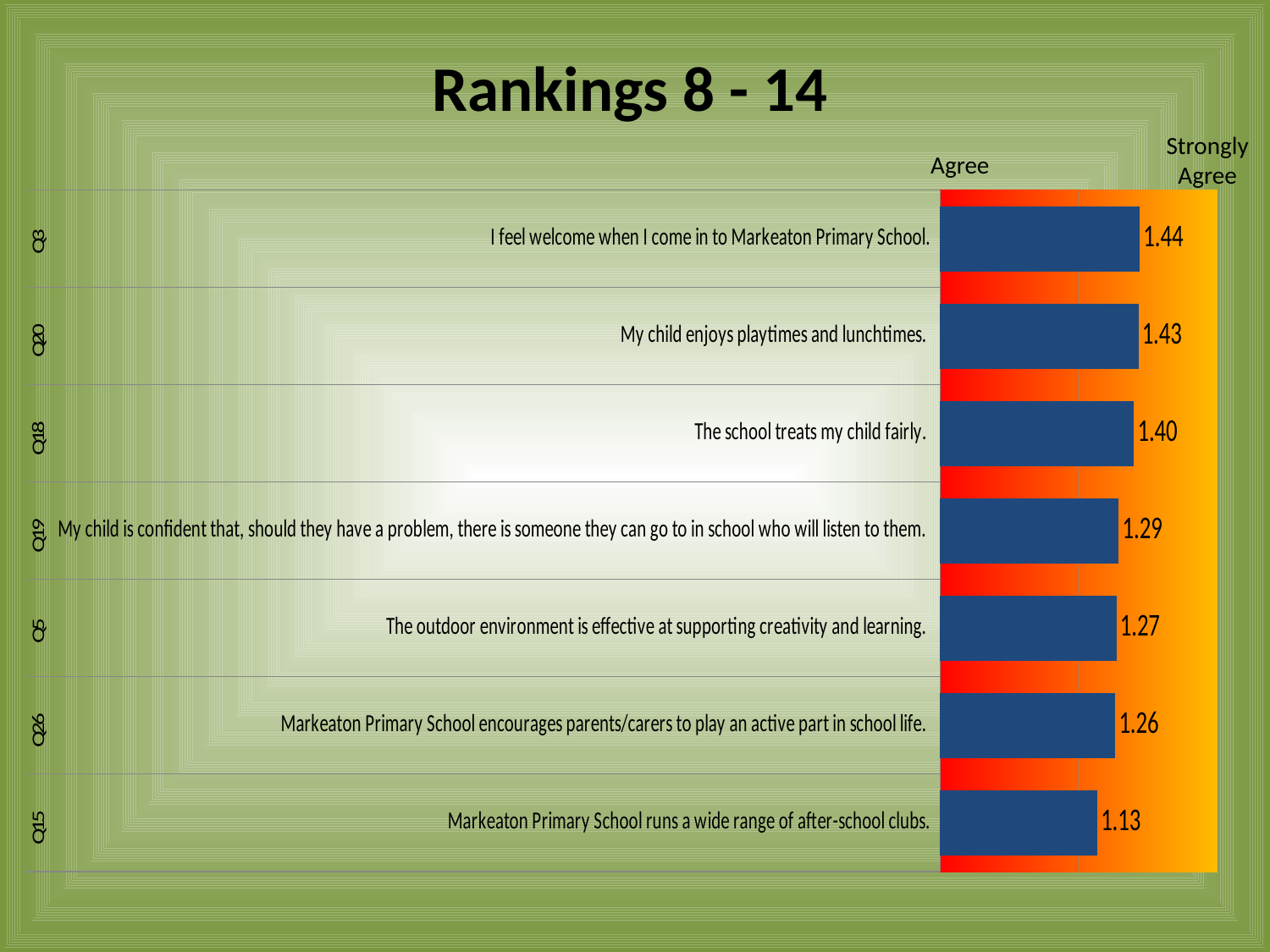
What is the value for "My child enjoys playtimes and lunchtimes."? 1.43 What are the two labels shown above the chart's value axis? Agree and Strongly Agree What is the value for "Markeaton Primary School runs a wide range of after-school clubs."? 1.13 What is the value for "I feel welcome when I come in to Markeaton Primary School."? 1.44 What is the difference between the values for "The school treats my child fairly." and "Markeaton Primary School runs a wide range of after-school clubs."? 0.27 What is the title of the slide? Rankings 8 - 14 Which statement has the highest value? I feel welcome when I come in to Markeaton Primary School. How many statements are plotted in the chart? 7 Which statement has the lowest value? Markeaton Primary School runs a wide range of after-school clubs. Which has a larger value: "The outdoor environment is effective at supporting creativity and learning." or "Markeaton Primary School runs a wide range of after-school clubs."? The outdoor environment is effective at supporting creativity and learning. What kind of chart is shown on the slide? Bar chart What is the value for "The school treats my child fairly."? 1.40